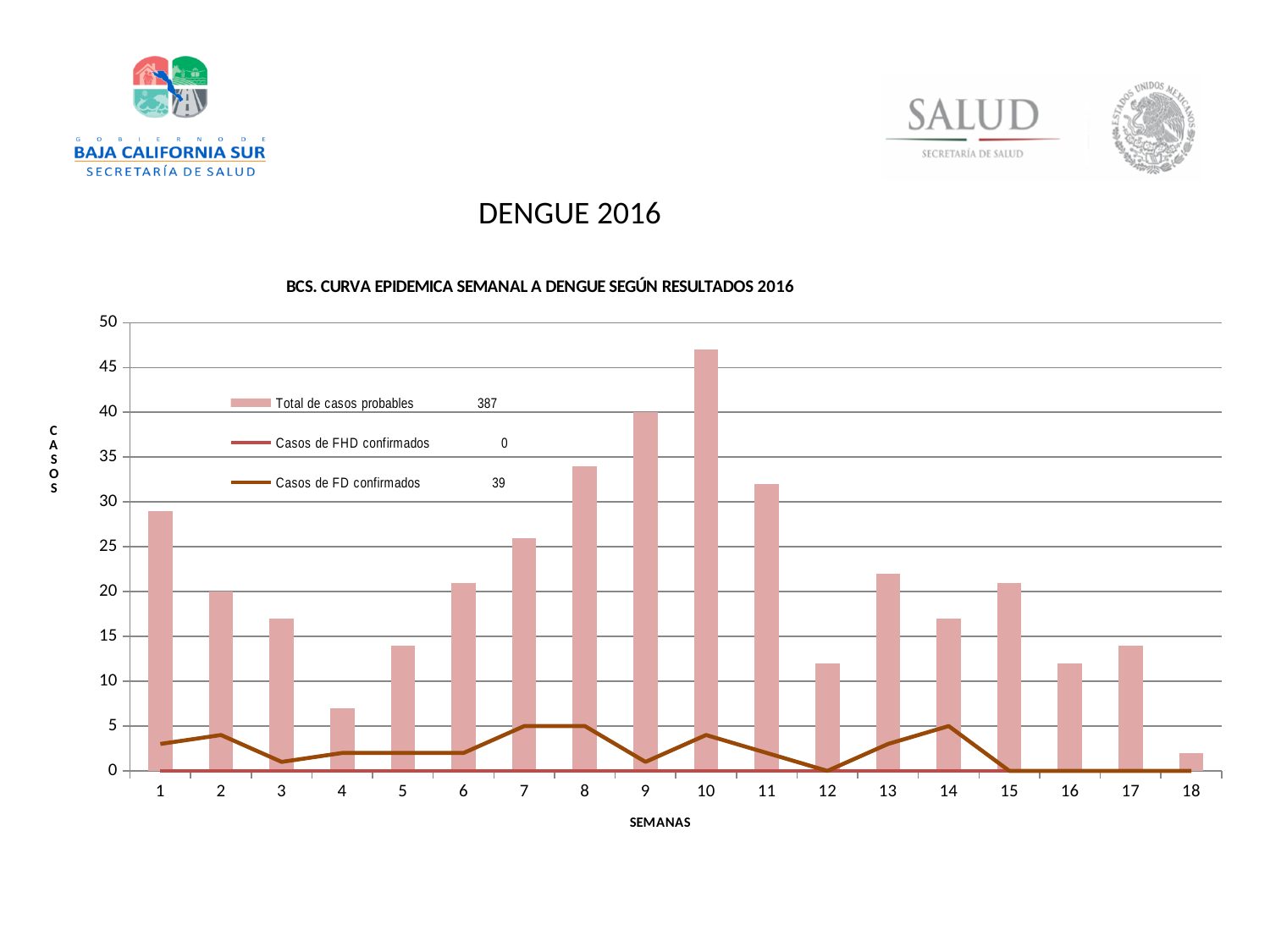
Which week (semana) has the highest bar for 'Total de casos probables'? 10 Which week (semana) has the lowest bar for 'Total de casos probables'? 18 Do the 'Total de casos probables' values rise or fall from week 6 to week 10? rise Is the 'Total de casos probables' value for week 4 greater or less than 10? less What is the total shown in the legend for 'Casos de FD confirmados'? 39 How many series does the legend list? 3 What is the total shown in the legend for 'Casos de FHD confirmados'? 0 Is the 'Total de casos probables' value for week 10 greater or less than 45? greater Is the 'Total de casos probables' value for week 8 greater or less than 30? greater How many weeks (semanas) are shown on the x axis? 18 What is the total shown in the legend for 'Total de casos probables'? 387 Which week has a larger 'Total de casos probables' bar, week 1 or week 2? Week 1